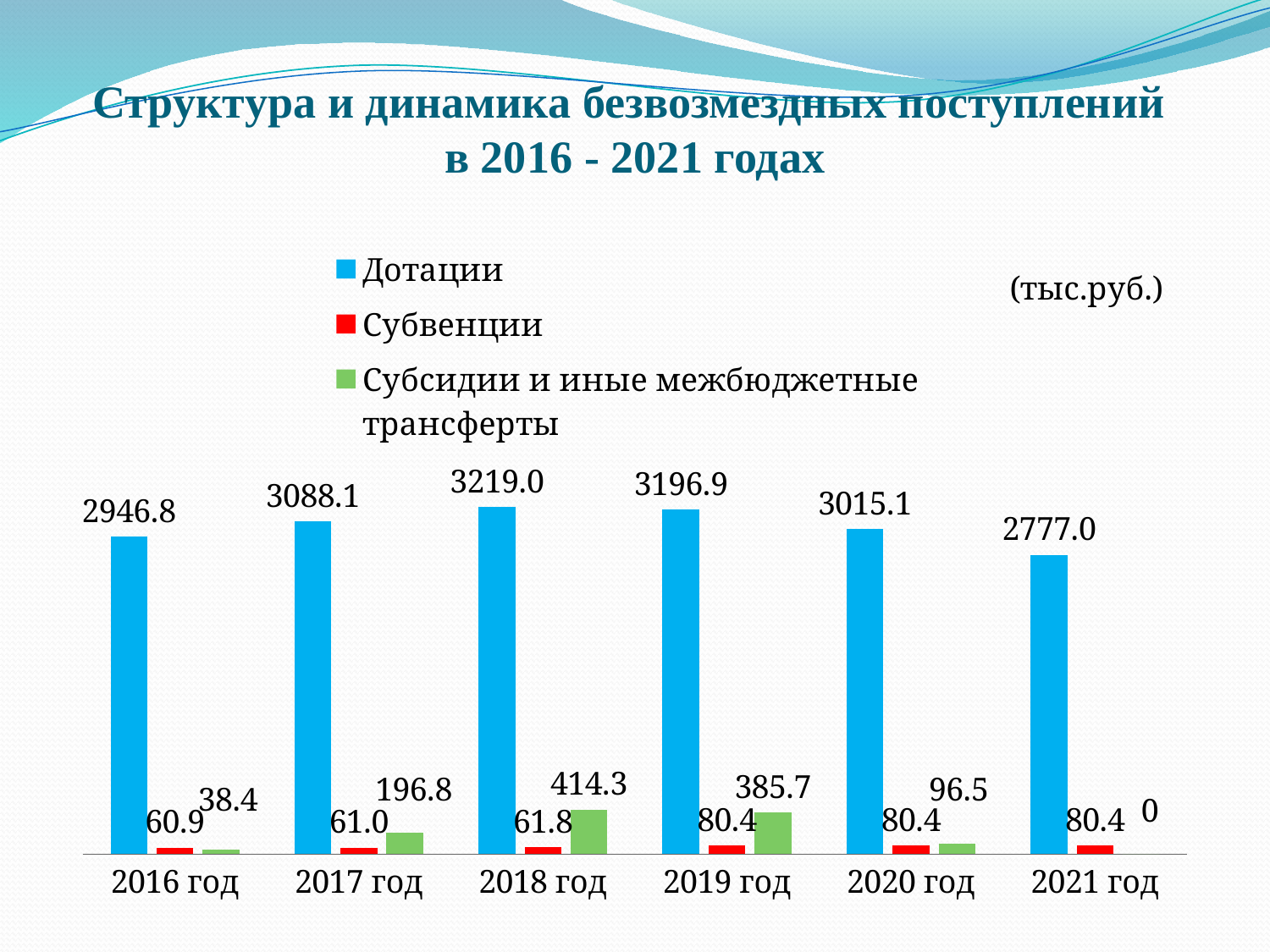
In which year is the Субсидии и иные межбюджетные трансферты value highest? 2018 год What unit is indicated for the values on the chart? тыс.руб. How many years are shown on the x axis? 6 What is the value of Дотации for 2018 год? 3219.0 What is the value of Субсидии и иные межбюджетные трансферты for 2019 год? 385.7 What kind of chart is shown on the slide? Bar chart What is the value of Субвенции for 2016 год? 60.9 How many series does the legend list? 3 In which year is the Дотации value highest? 2018 год In which year is the Дотации value lowest? 2021 год What is the difference between the Дотации values for 2018 год and 2021 год? 442.0 Which is larger: Субсидии и иные межбюджетные трансферты in 2017 год or in 2020 год? 2017 год